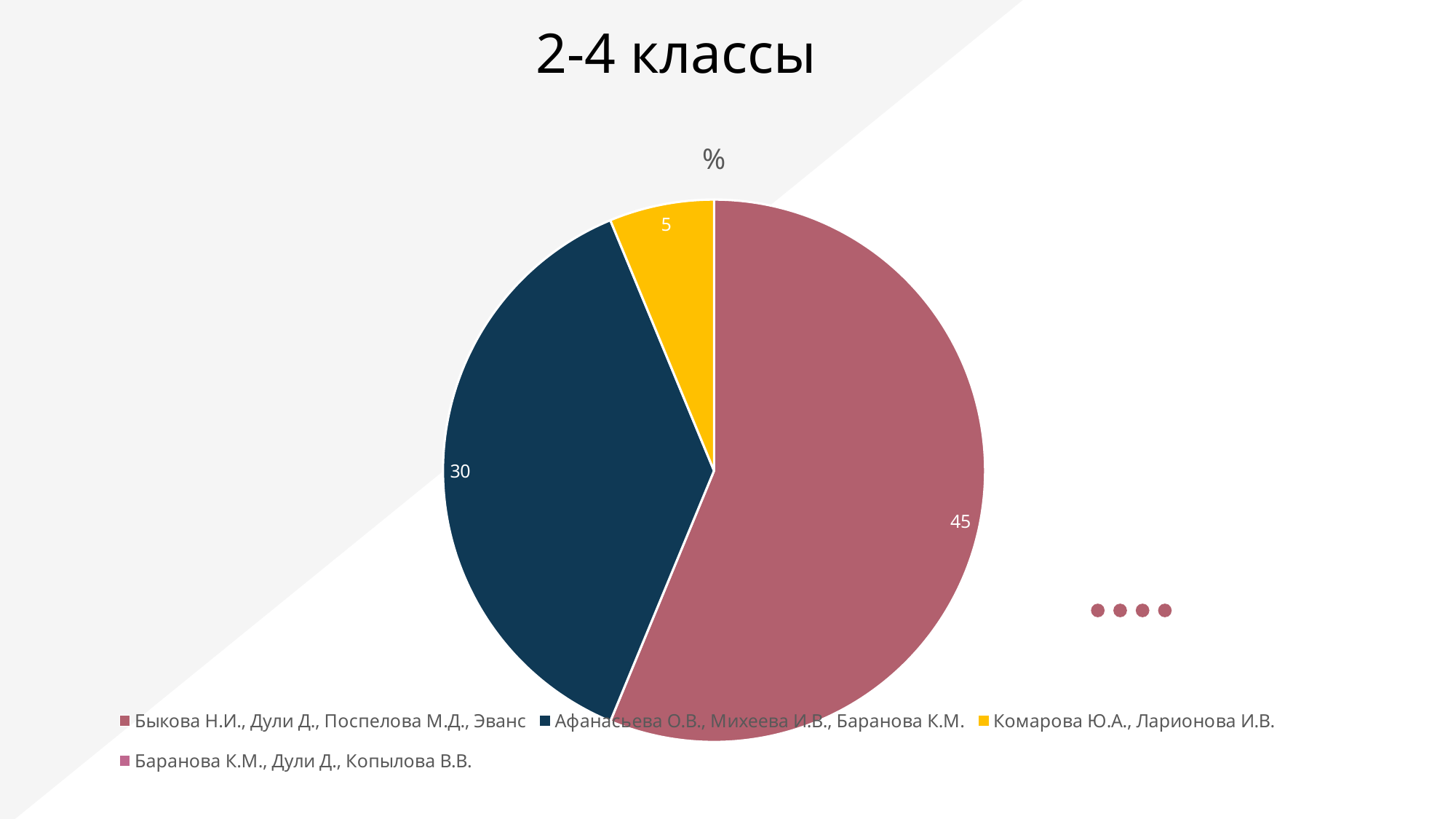
What kind of chart is shown on the slide? pie chart What colour is the slice for Комарова Ю.А., Ларионова И.В.? yellow What value is shown for Комарова Ю.А., Ларионова И.В.? 5 Which legend entry has the smallest slice? Комарова Ю.А., Ларионова И.В. What value is shown for Быкова Н.И., Дули Д., Поспелова М.Д., Эванс? 45 What is the difference between the values for Афанасьева О.В., Михеева И.В., Баранова К.М. and Комарова Ю.А., Ларионова И.В.? 25 How many entries does the legend list? 4 What is the title of the chart? % What value is shown for Афанасьева О.В., Михеева И.В., Баранова К.М.? 30 Which is larger: the value for Афанасьева О.В., Михеева И.В., Баранова К.М. or the value for Комарова Ю.А., Ларионова И.В.? Афанасьева О.В., Михеева И.В., Баранова К.М. Which legend entry has the largest slice? Быкова Н.И., Дули Д., Поспелова М.Д., Эванс